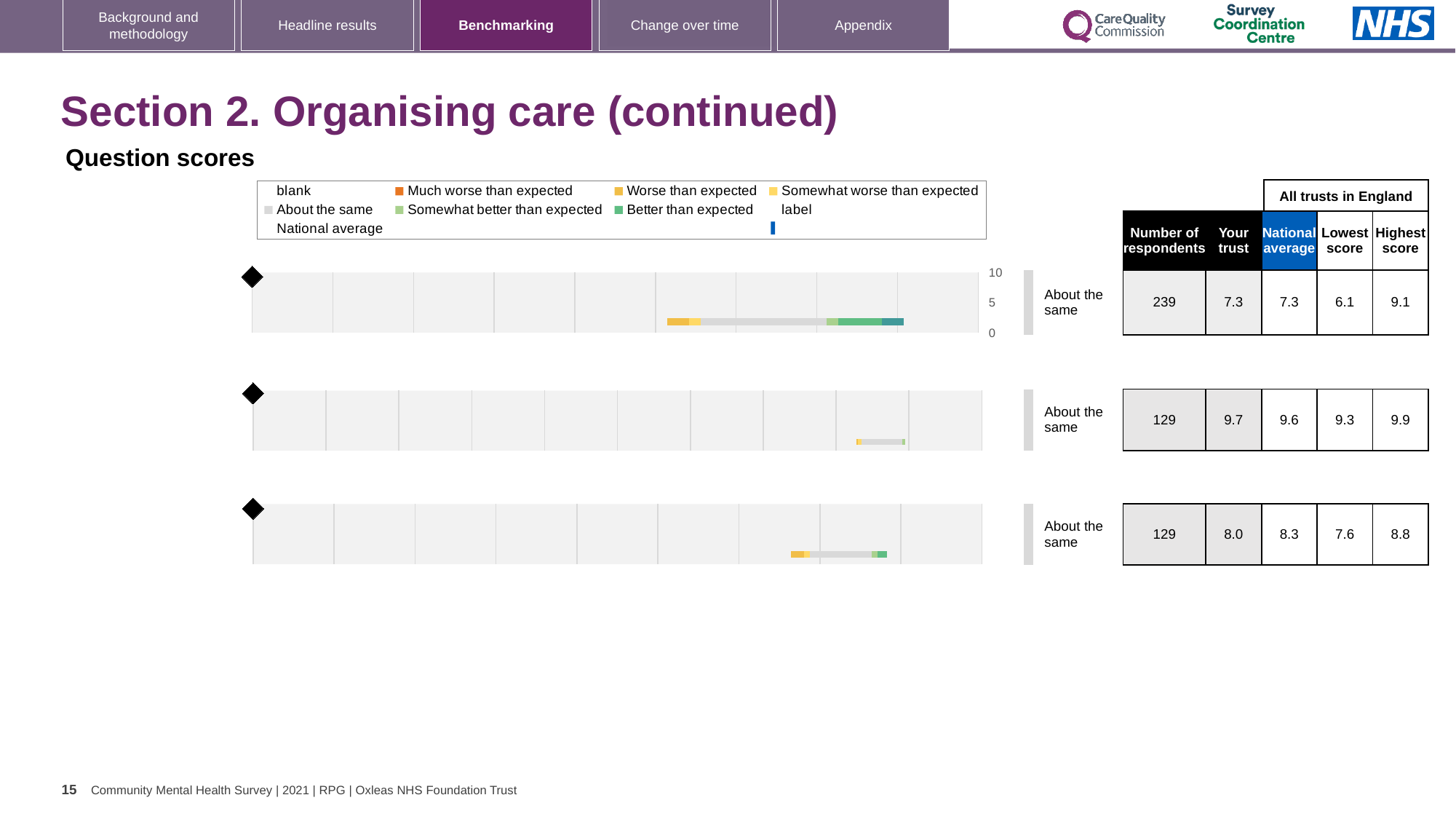
For the top chart, what is the difference between the highest score and the lowest score among all trusts in England? 3.0 For the bottom chart, what is the highest score among all trusts in England? 8.8 In the top chart, is the 'Your trust' score greater or less than 5 on the axis? greater For the top chart, what is the 'Your trust' score shown in the table? 7.3 What kind of chart is used for the three question score rows on the slide? bar chart For the top chart, how many respondents are listed? 239 For the middle chart, what is the national average score? 9.6 What benchmark category is shown next to each of the three charts? About the same What is the maximum value shown on the score axis of the top chart? 10 Which of the three charts has the highest 'Your trust' score? the middle chart (9.7) For the bottom chart, is the 'Your trust' score or the national average larger? national average (8.3) How many question score charts are shown on the slide? 3